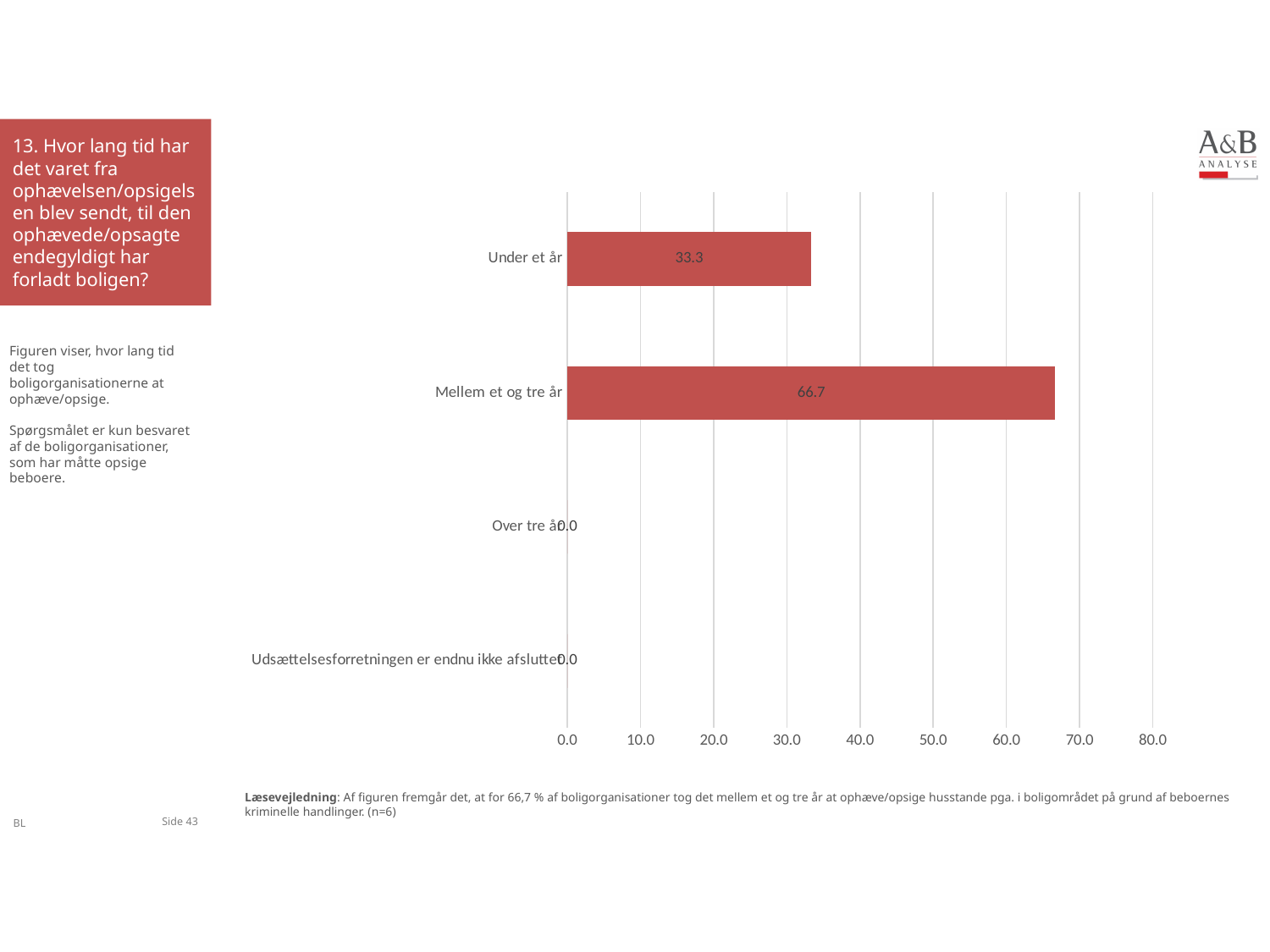
Which is larger, the value for "Under et år" or the value for "Mellem et og tre år"? Mellem et og tre år Is the value for "Under et år" greater or less than 40.0? less Is the value for "Mellem et og tre år" greater or less than 60.0? greater What is the value for "Udsættelsesforretningen er endnu ikke afsluttet"? 0.0 What is the value for "Over tre år"? 0.0 What is the highest tick value shown on the horizontal axis? 80.0 What kind of chart is shown on the slide? bar chart What is the value for "Mellem et og tre år"? 66.7 How many categories are shown in the chart? 4 What is the value for "Under et år"? 33.3 What is the difference between the values for "Mellem et og tre år" and "Under et år"? 33.4 Which category has the highest value? Mellem et og tre år